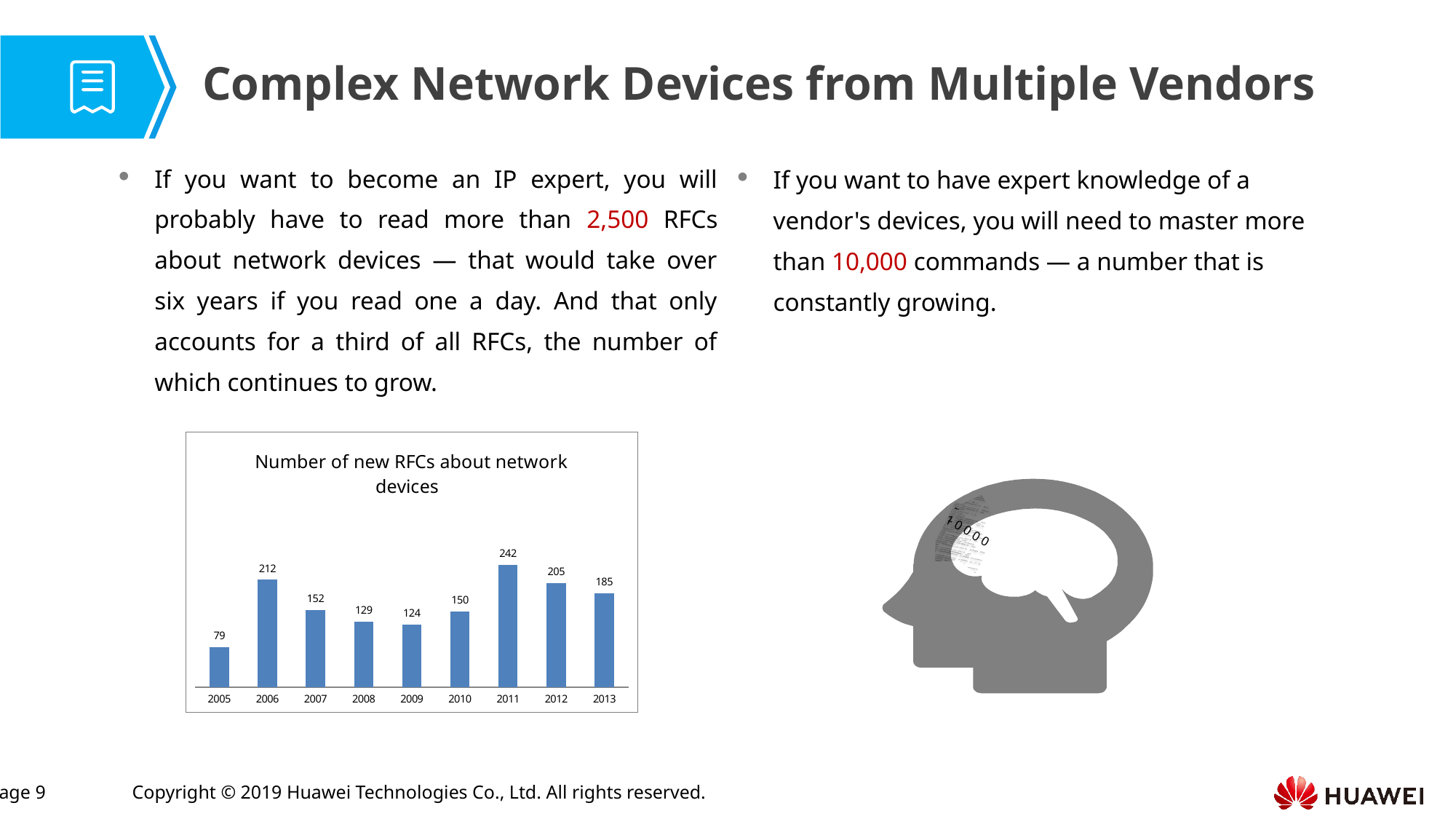
Which year has a larger value, 2008 or 2009? 2008 What is the difference between the values for 2011 and 2005? 163 What kind of chart is used to show the number of new RFCs about network devices? Bar chart What is the number of new RFCs about network devices in 2005? 79 What is the number of new RFCs about network devices in 2011? 242 How many years are shown on the x axis of the chart? 9 What is the difference between the values for 2006 and 2007? 60 Which year has the lowest number of new RFCs about network devices? 2005 What is the value shown for 2013? 185 Which year has the highest number of new RFCs about network devices? 2011 What is the title of the chart? Number of new RFCs about network devices Which year has a larger value, 2012 or 2013? 2012